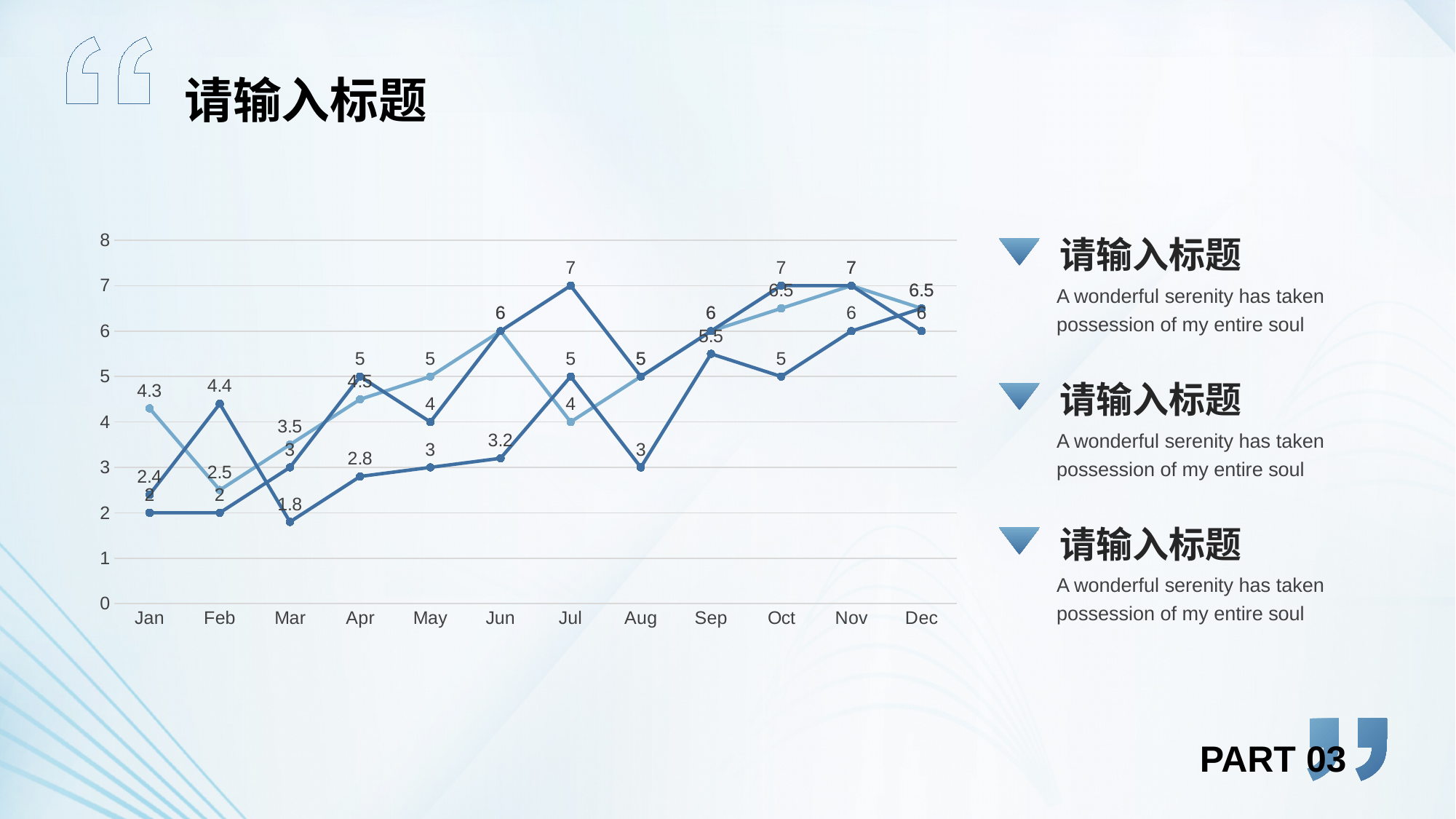
What is the difference between the light blue line's Nov value and its Jan value? 2.7 What is the highest value labelled on the chart? 7 What is the value of the light blue line in Oct? 6.5 What is the highest tick value shown on the y axis? 8 For the light blue line, which is larger, the Jan value or the Feb value? Jan What is the value of the light blue line in Nov? 7 Is the light blue line's value in Jul greater or less than 5? less How many lines are plotted on the chart? 3 What kind of chart is shown on the slide? line chart How many categories are shown on the x axis of the chart? 12 What is the value of the light blue line in Jan? 4.3 What is the lowest value labelled anywhere on the chart, and in which month does it occur? 1.8 in Mar